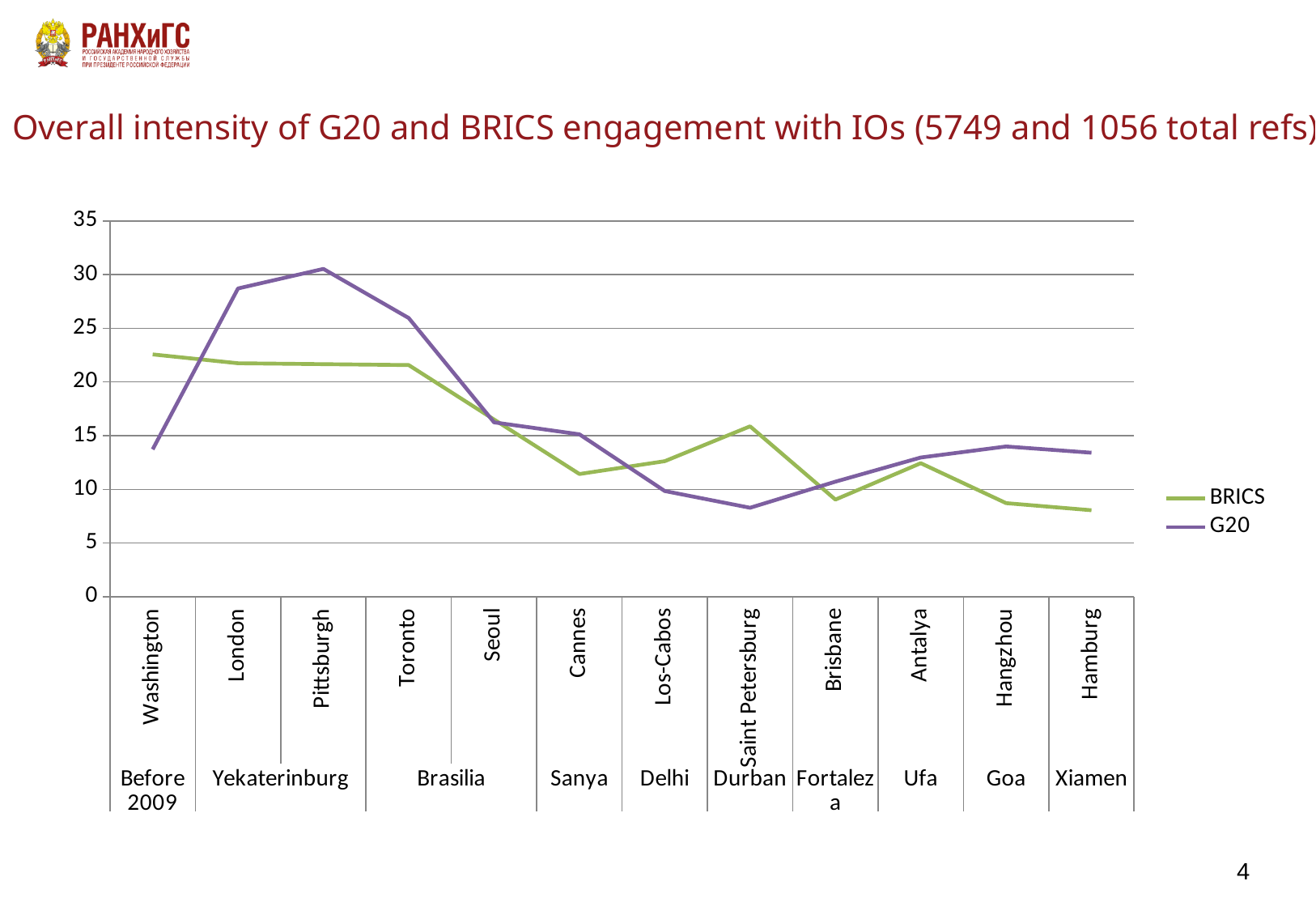
Is the BRICS value for Hamburg greater or less than 10? less At Pittsburgh, which series has the higher value, BRICS or G20? G20 Is the G20 value for London greater or less than 25? greater At which summit does the G20 line reach its lowest value? Saint Petersburg At which summit does the G20 line reach its highest value? Pittsburgh Does the G20 line rise or fall from Pittsburgh to Saint Petersburg? fall How many series does the legend list? 2 Is the BRICS value for Cannes greater or less than 15? less What kind of chart is shown on the slide? line chart How many summit points are plotted along the x axis? 12 At Saint Petersburg, which series has the higher value, BRICS or G20? BRICS